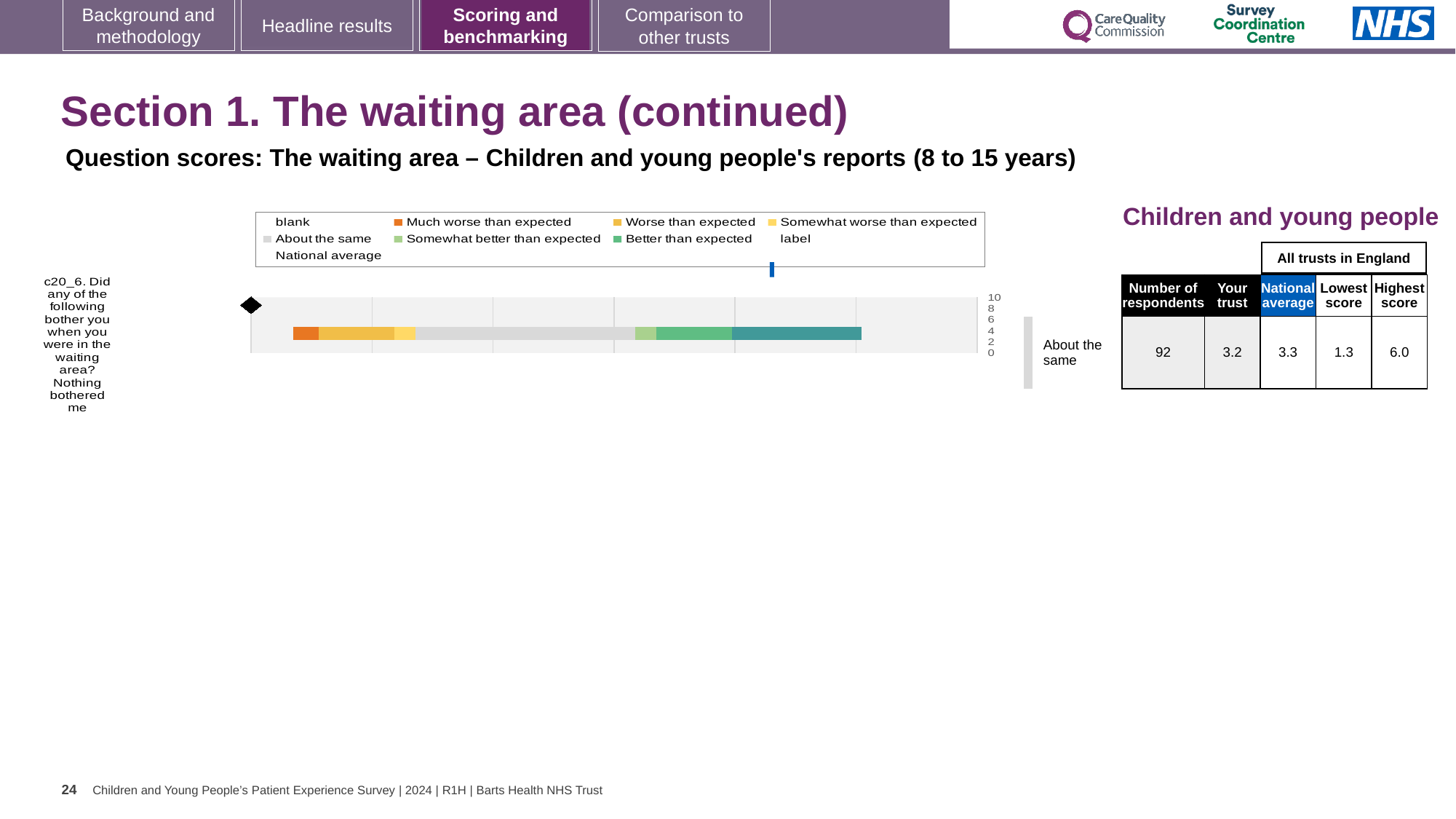
What is the highest score across all trusts in England for question c20_6? 6.0 By how much does the national average exceed the 'Your trust' score for question c20_6? 0.1 How many respondents answered question c20_6? 92 How many survey questions are plotted as bars in the chart? 1 What is the 'Your trust' score for question c20_6? 3.2 Which legend entry is shown in orange? Much worse than expected What kind of chart is shown on the slide? bar chart What is the difference between the highest score and the lowest score for question c20_6? 4.7 What is the national average score for question c20_6? 3.3 Which is larger for question c20_6: the 'Your trust' score or the national average? National average What is the lowest score across all trusts in England for question c20_6? 1.3 What benchmark category label is shown next to the bar for question c20_6? About the same